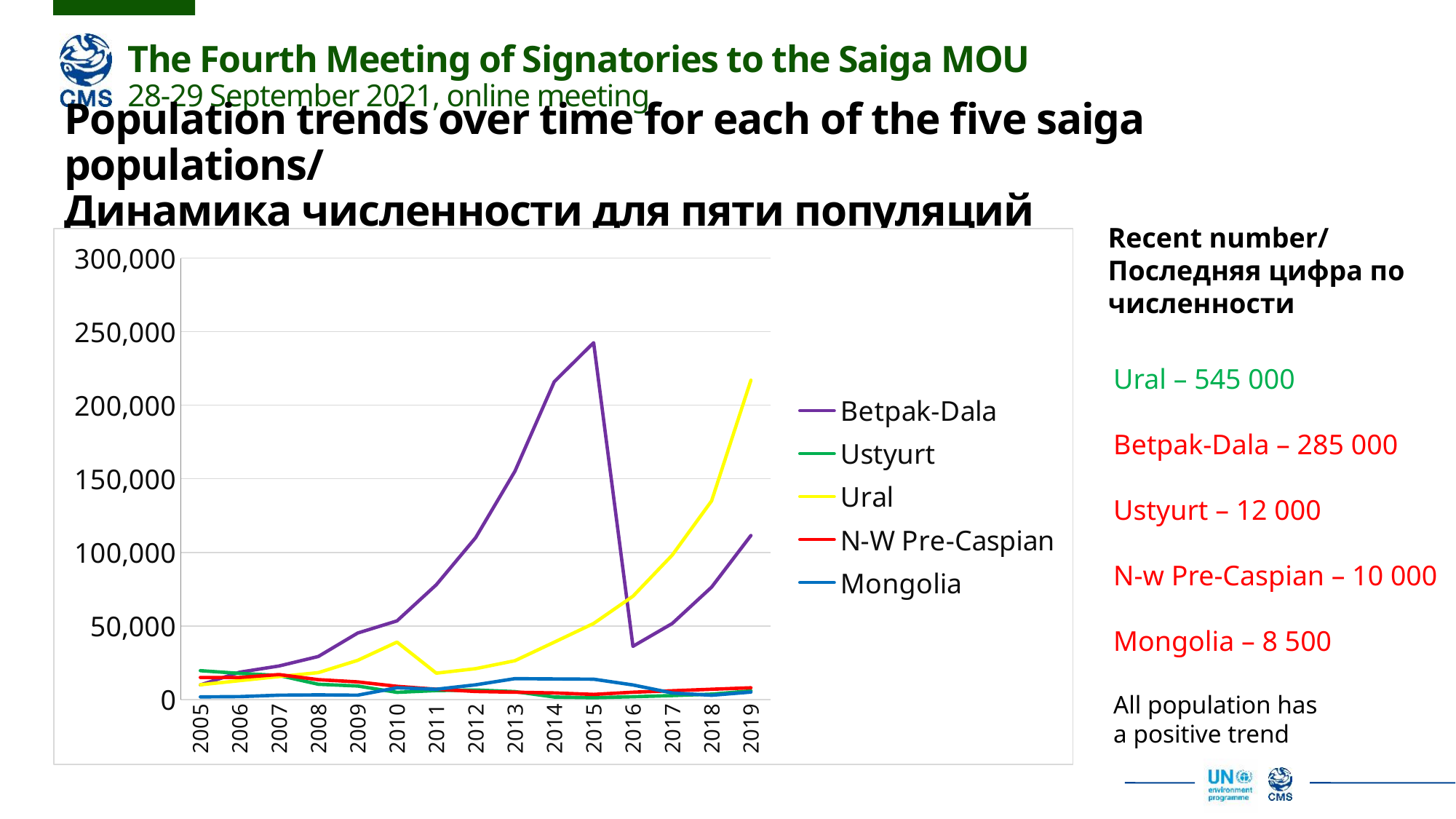
In 2019, which is larger: the value for Ural or the value for Betpak-Dala? Ural What kind of chart is shown on the slide? line chart How many years are shown along the x axis of the chart? 15 Is the value for Betpak-Dala in 2016 greater or less than 50,000? less Does the Ural series rise or fall between 2016 and 2019? rise Does the Betpak-Dala series rise or fall between 2015 and 2016? fall How many series does the chart's legend list? 5 Which series has the highest value in 2019? Ural Is the value for Ural in 2019 greater or less than 200,000? greater What colour is the Ural line in the chart? yellow Is the value for Betpak-Dala in 2015 greater or less than 200,000? greater Which series reaches the highest value in 2015? Betpak-Dala